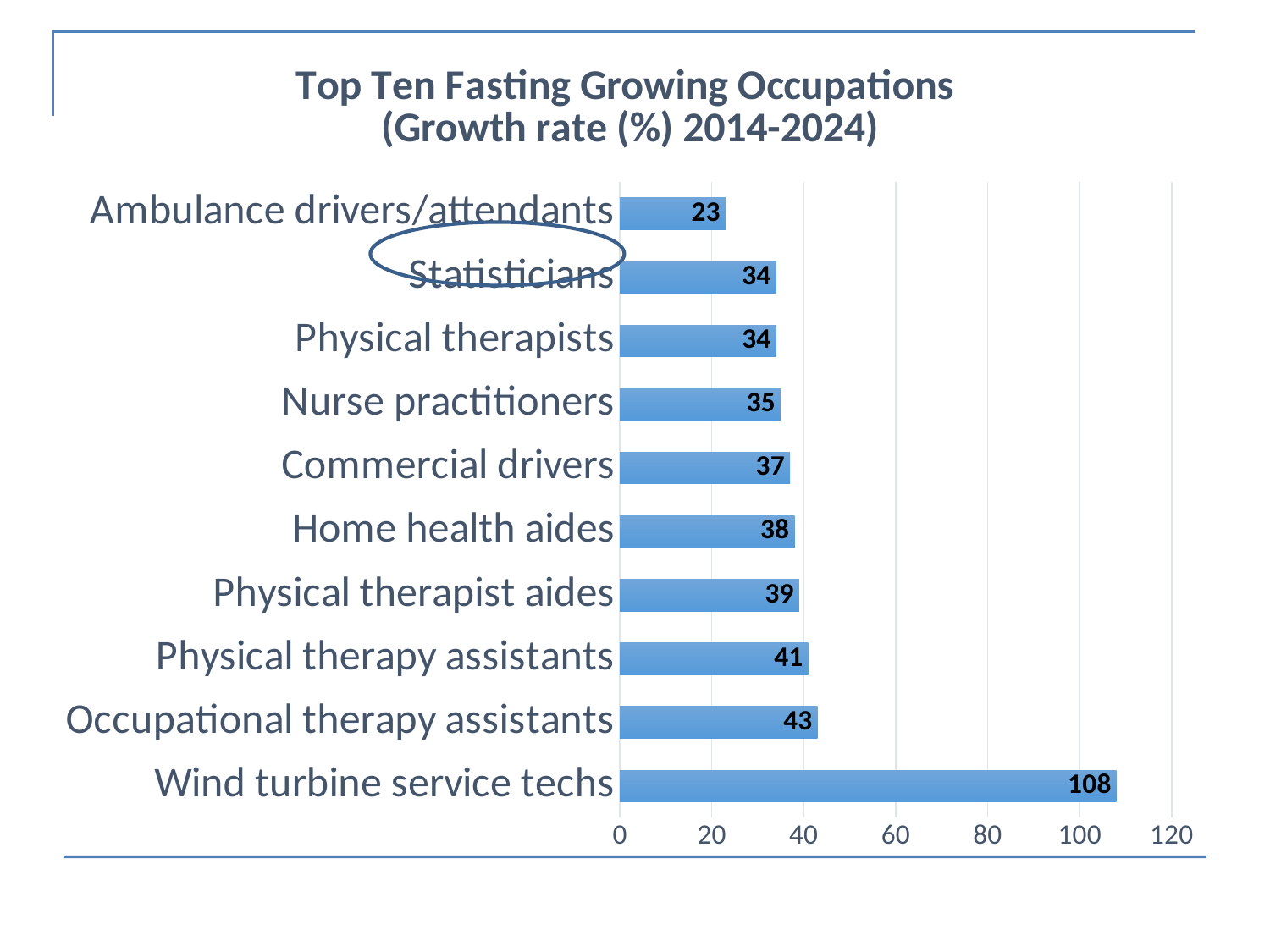
What is the growth rate for Occupational therapy assistants? 43 Which has a higher growth rate, Home health aides or Nurse practitioners? Home health aides What is the growth rate for Ambulance drivers/attendants? 23 Is the growth rate for Wind turbine service techs greater or less than 100? greater How many occupations are shown in the chart? 10 What is the difference between the growth rates of Physical therapy assistants and Ambulance drivers/attendants? 18 What type of chart is shown on the slide? Bar chart What is the growth rate for Wind turbine service techs? 108 What is the difference between the growth rates of Wind turbine service techs and Occupational therapy assistants? 65 Which occupation has the lowest growth rate? Ambulance drivers/attendants What is the growth rate for Statisticians? 34 Which occupation has the highest growth rate? Wind turbine service techs